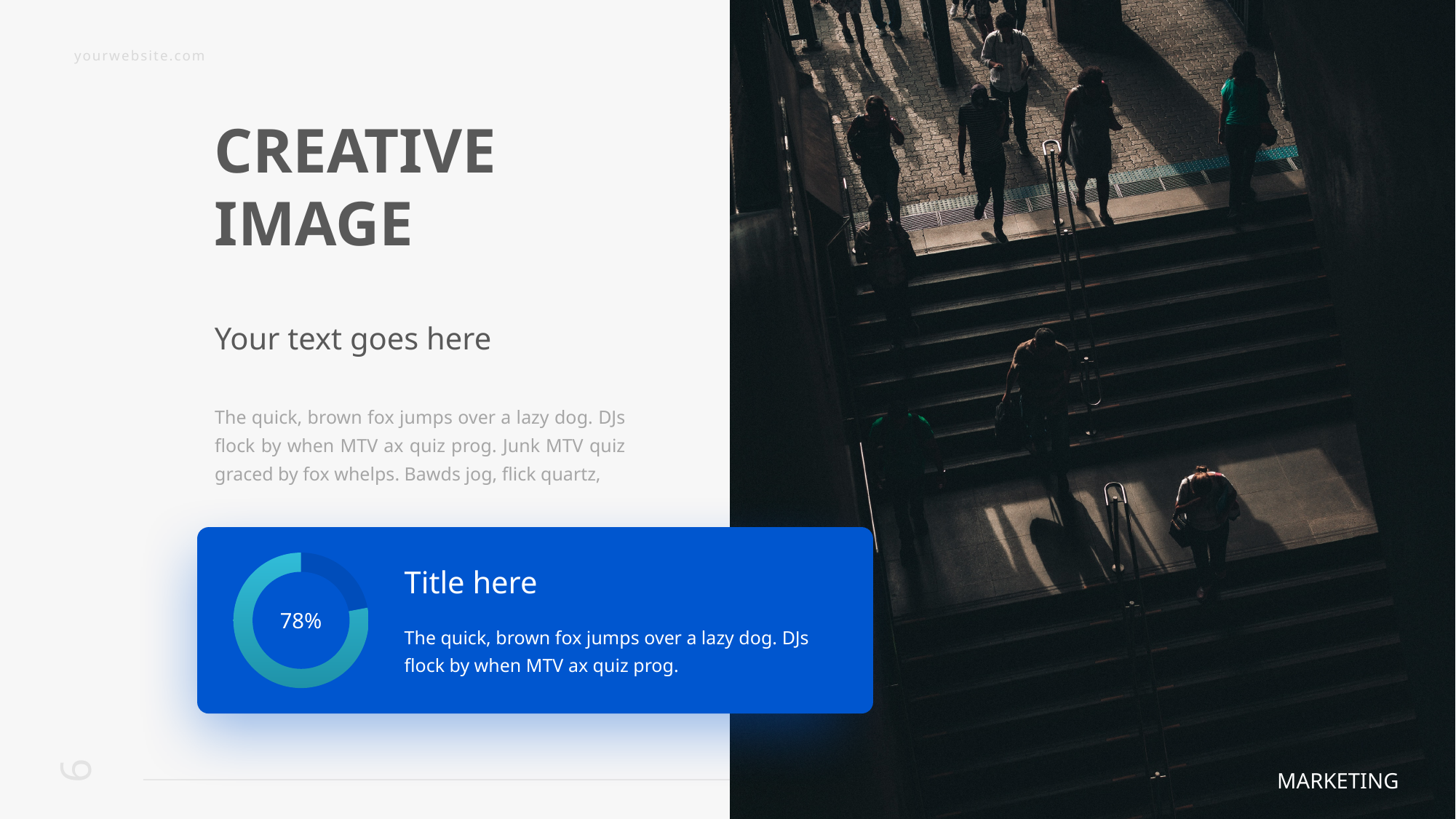
Is the value shown in the donut chart greater or less than 50%? greater How many donut charts are on the slide? 1 What share of the donut chart is filled by the highlighted segment? 78% What colour is the background of the box containing the donut chart? Blue Is the value shown in the donut chart greater or less than 80%? less What kind of chart is shown in the blue box on the slide? Donut chart What percentage is printed in the centre of the donut chart? 78% What is the title text printed next to the donut chart? Title here